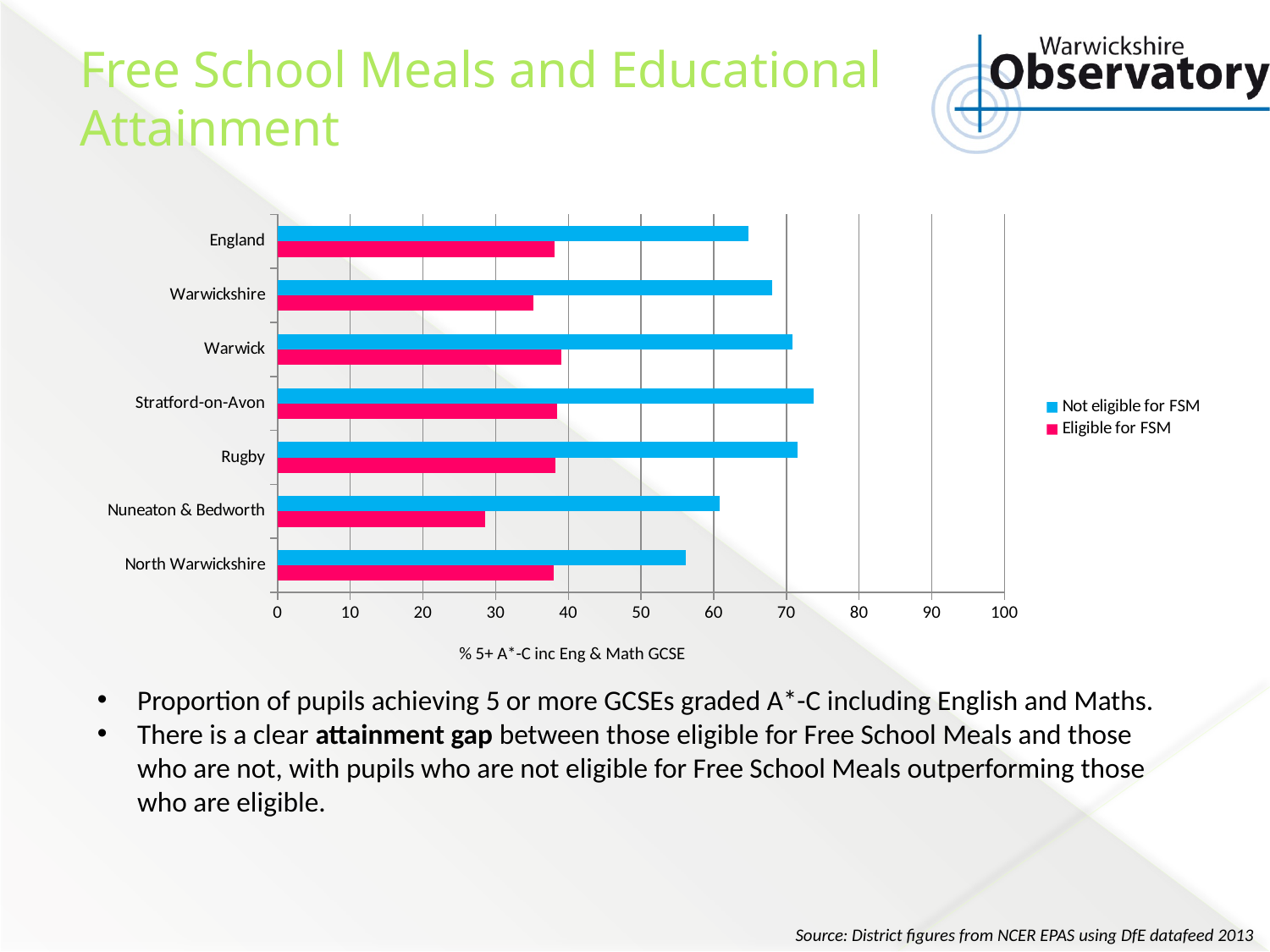
How many series does the legend list? 2 Is the value for North Warwickshire pupils not eligible for FSM greater or less than 60? less What kind of chart is shown on the slide? Bar chart What is the label on the horizontal axis of the chart? % 5+ A*-C inc Eng & Math GCSE Is the value for Nuneaton & Bedworth pupils eligible for FSM greater or less than 30? less Which area has the lowest value for pupils eligible for FSM? Nuneaton & Bedworth Which is larger: the value for Warwickshire or for Nuneaton & Bedworth among pupils eligible for FSM? Warwickshire Which is larger: the value for Warwick or for Nuneaton & Bedworth among pupils not eligible for FSM? Warwick Which area has the lowest value for pupils not eligible for FSM? North Warwickshire How many areas (categories) are plotted on the chart? 7 Which area has the highest value for pupils not eligible for FSM? Stratford-on-Avon Is the value for Stratford-on-Avon pupils not eligible for FSM greater or less than 70? greater